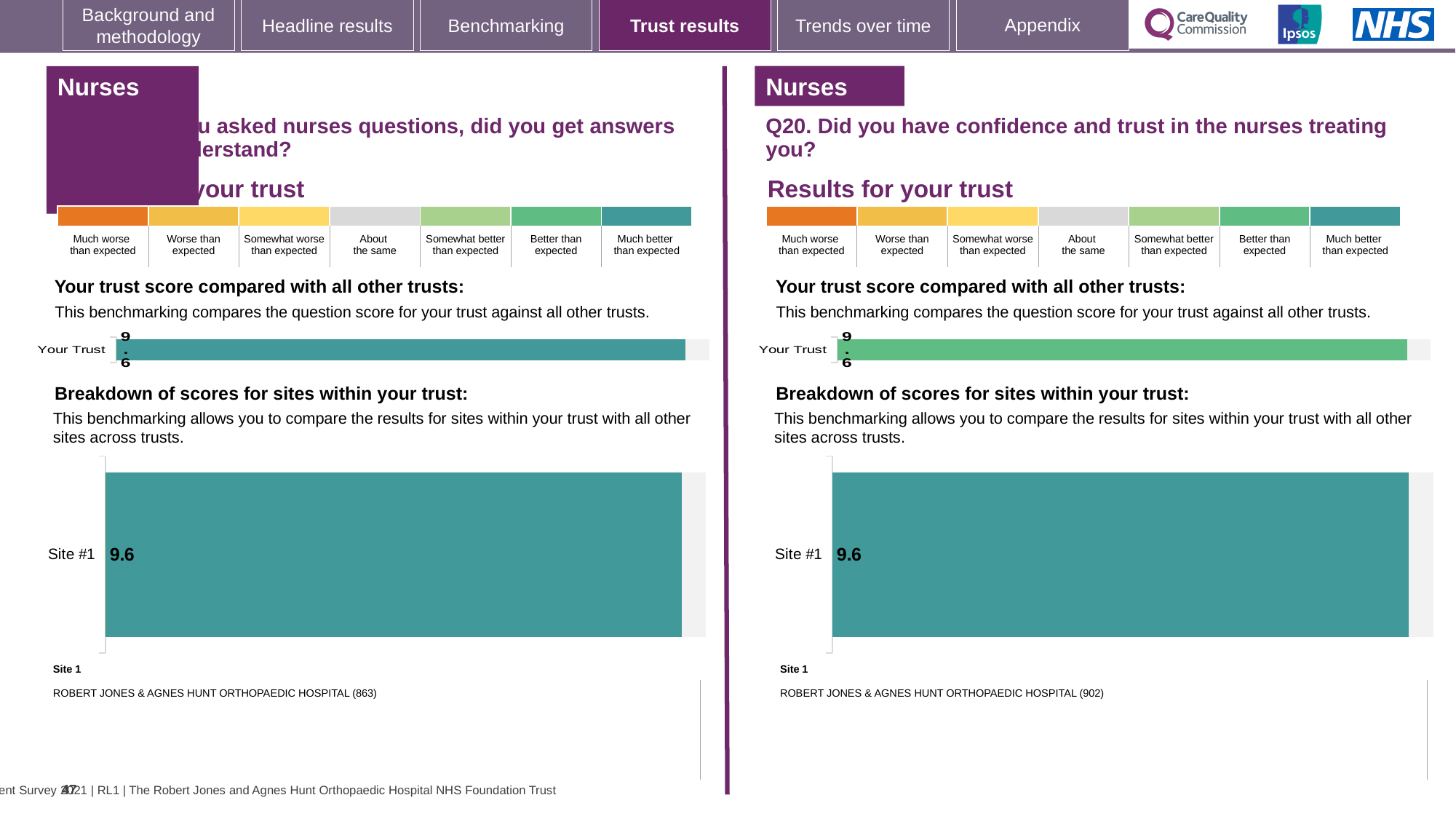
On the right-hand Q20 chart, what is the score shown for Your Trust? 9.6 What kind of chart is used to show Your Trust score on the left-hand side of the slide? Bar chart How many sites are shown in the right-hand Q20 'Breakdown of scores for sites within your trust' chart? 1 On the right-hand Q20 'Breakdown of scores for sites within your trust' chart, what is the score for Site #1? 9.6 On the left-hand 'Breakdown of scores for sites within your trust' chart, what is the score for Site #1? 9.6 Which site is labelled as Site 1 on the right-hand Q20 side of the slide? ROBERT JONES & AGNES HUNT ORTHOPAEDIC HOSPITAL (902) How many bars are plotted in the left-hand 'Your trust score compared with all other trusts' chart? 1 What kind of chart is used for the Site #1 breakdown on the right-hand Q20 side? Bar chart On the right-hand Q20 'Your trust score compared with all other trusts' chart, which benchmark category does the green colour of the Your Trust bar correspond to in the key? Better than expected Is the Site #1 score on the left-hand breakdown chart the same as the Site #1 score on the right-hand Q20 breakdown chart? Yes, both are 9.6 On the left-hand 'Your trust score compared with all other trusts' chart, what is the score shown for Your Trust? 9.6